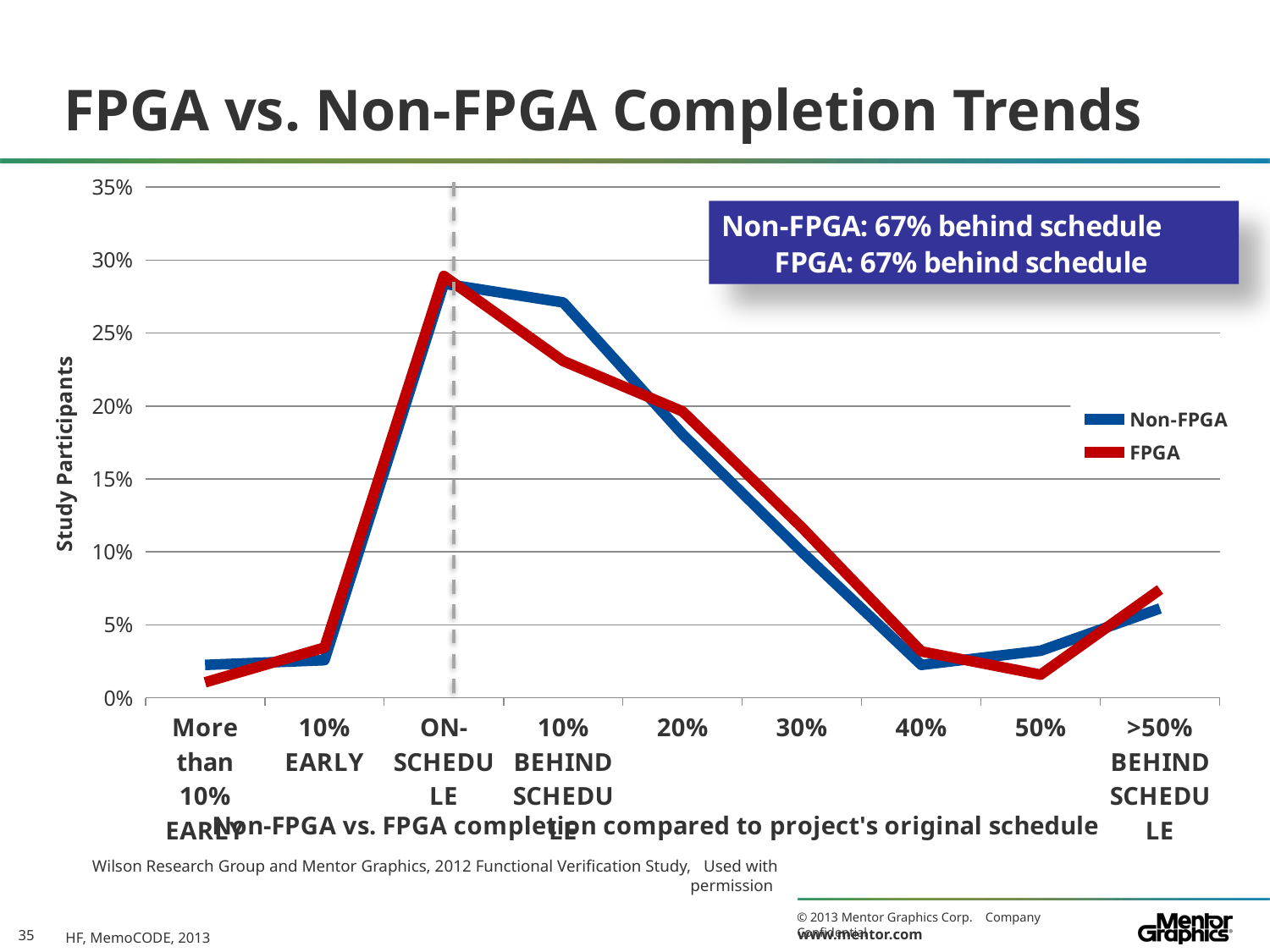
Is the FPGA value at >50% BEHIND SCHEDULE greater or less than 5%? greater Which colour is used for the FPGA series? Red At 10% BEHIND SCHEDULE, which series has the larger value, Non-FPGA or FPGA? Non-FPGA Do the values for both series rise or fall from ON-SCHEDULE to 40%? fall Is the FPGA value at 10% BEHIND SCHEDULE greater or less than 25%? less How many series does the legend list? 2 Is the Non-FPGA value at 40% greater or less than 5%? less How many categories are shown along the x axis? 9 At which category does the FPGA line reach its highest value? ON-SCHEDULE What kind of chart is shown on the slide? Line chart At which category does the Non-FPGA line reach its highest value? ON-SCHEDULE